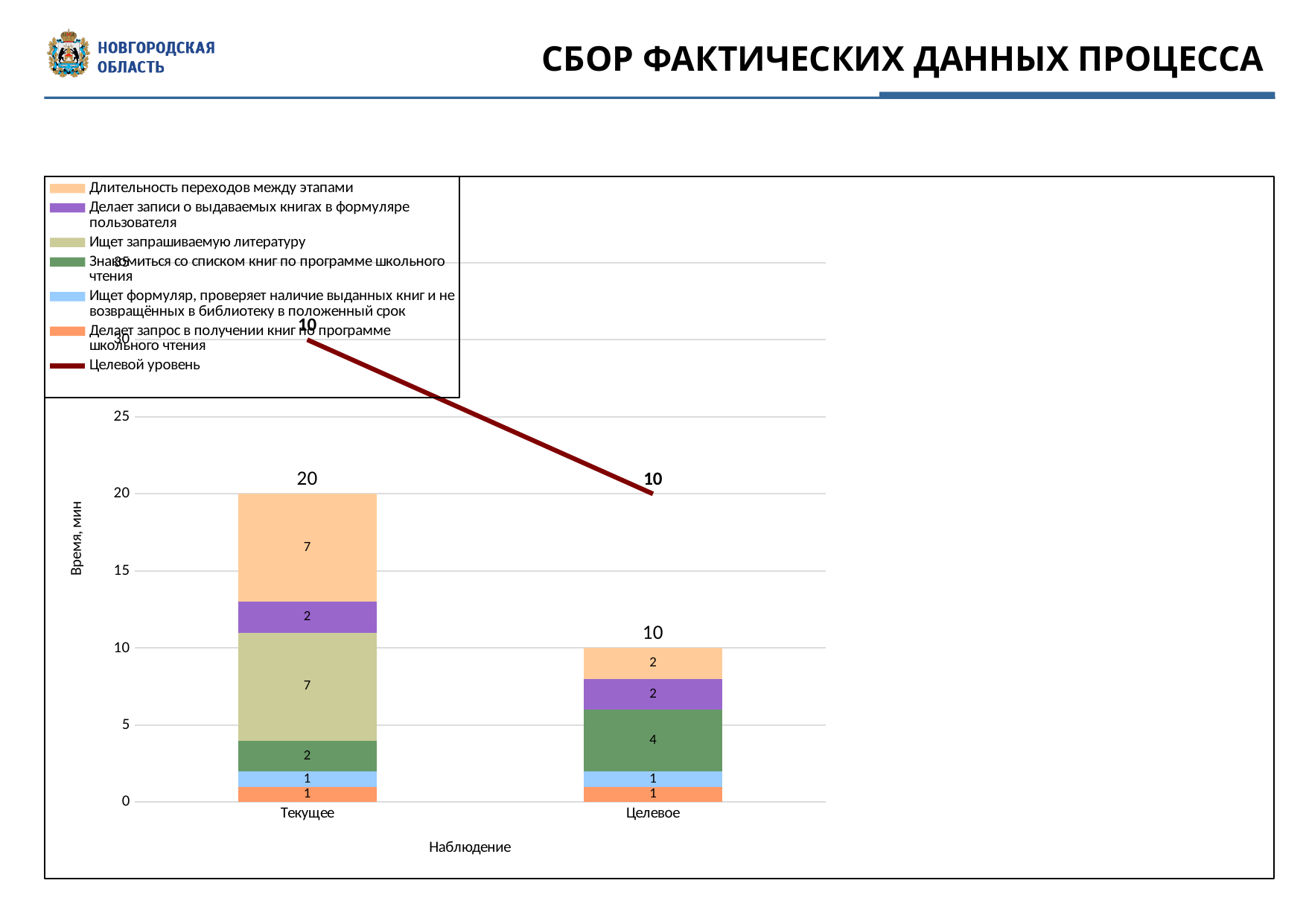
What is the total of the stacked bar for Целевое? 10 What is the value of Делает записи о выдаваемых книгах в формуляре пользователя for Текущее? 2 How many categories are shown on the x axis? 2 Which category has the higher total, Текущее or Целевое? Текущее What is the value of Ищет запрашиваемую литературу for Текущее? 7 What is the difference between the total for Текущее and the total for Целевое? 10 What kind of chart is shown on the slide? Combination chart: stacked bar chart with a line (Целевой уровень) What is the value of the Целевой уровень line at Целевое? 10 What is the total of the stacked bar for Текущее? 20 What is the value of Длительность переходов между этапами for Целевое? 2 How many entries does the legend list? 7 What is the value of Знакомиться со списком книг по программе школьного чтения for Целевое? 4